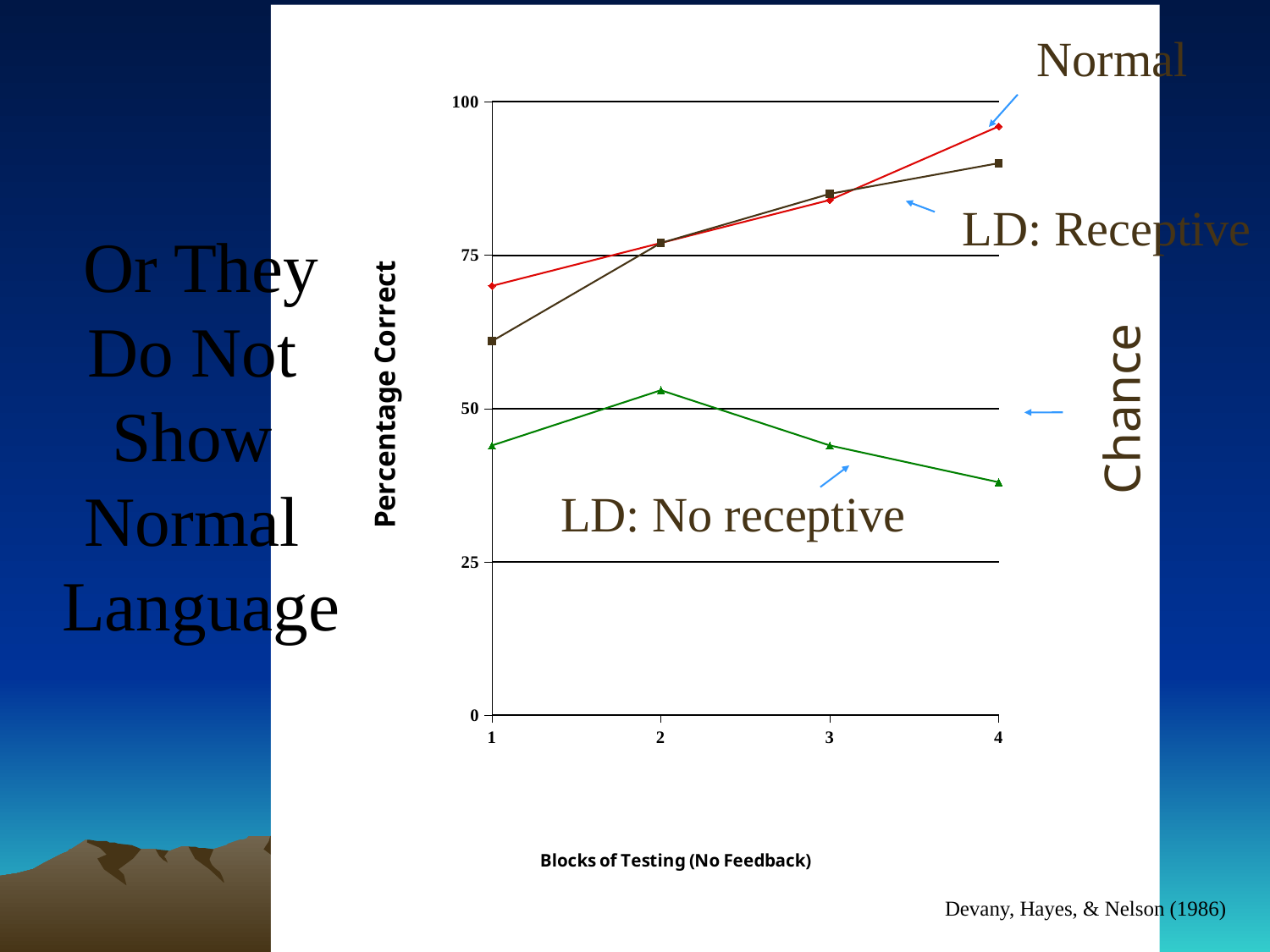
What kind of chart is shown on the slide? line chart Is the value for LD: No receptive at block 4 greater or less than 50? less Which series has the lowest value at block 1? LD: No receptive Does the LD: No receptive line rise or fall from block 2 to block 4? fall Is the value for LD: Receptive at block 1 greater or less than 75? less How many blocks of testing are plotted along the x axis? 4 Which series has the highest value at block 4? Normal How many data series (lines) are plotted on the chart? 3 Does the Normal line rise or fall from block 1 to block 4? rise Is the value for Normal at block 4 greater or less than 75? greater At block 1, which is higher: Normal or LD: Receptive? Normal What is the title of the y axis? Percentage Correct